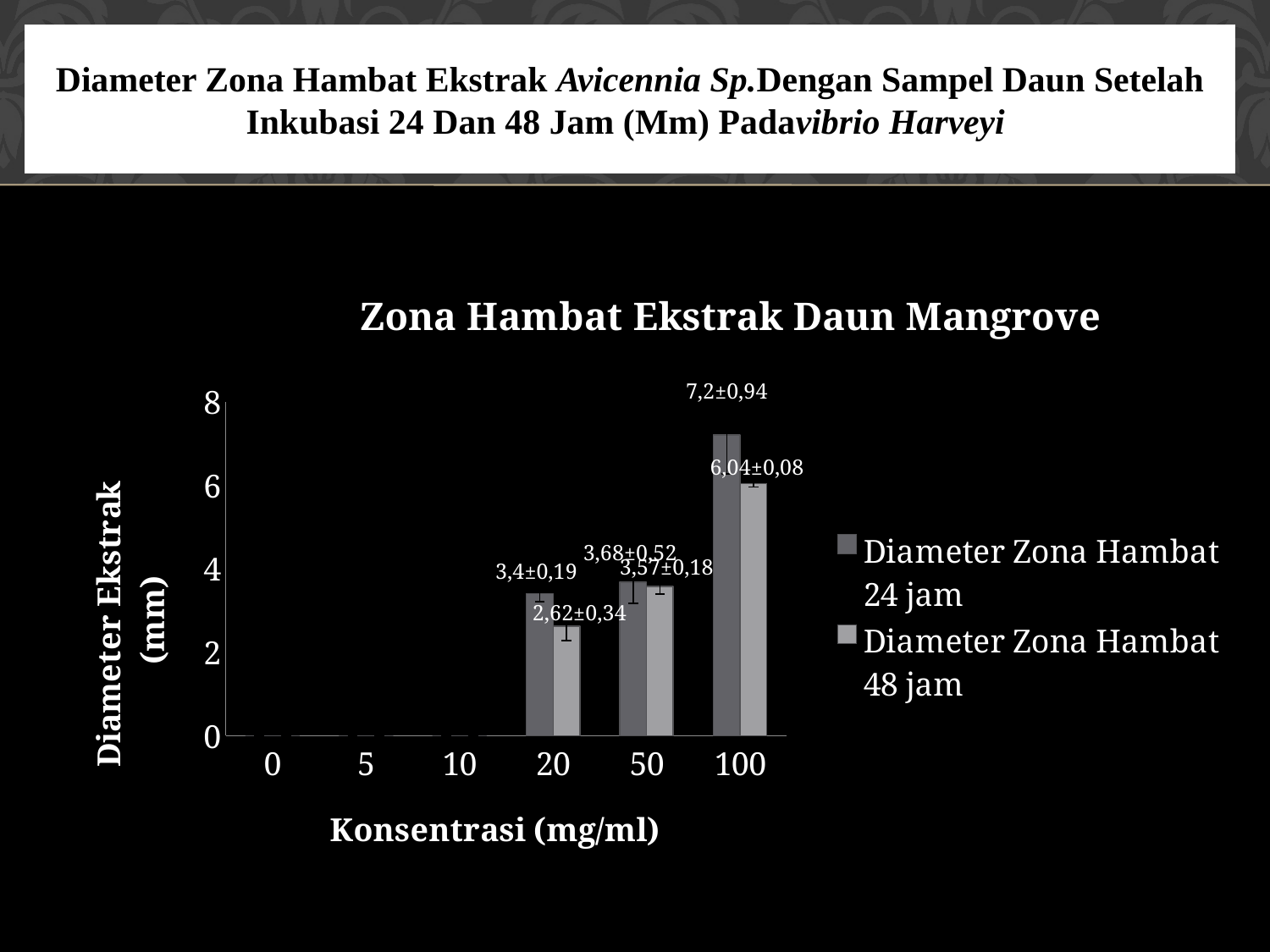
At concentration 20 mg/ml, which is larger: Diameter Zona Hambat 24 jam or Diameter Zona Hambat 48 jam? Diameter Zona Hambat 24 jam Among the concentrations 20, 50 and 100 mg/ml, which has the lowest Diameter Zona Hambat 48 jam value? 20 How many series does the legend list? 2 What is the data label for Diameter Zona Hambat 48 jam at concentration 50 mg/ml? 3,57±0,18 Which concentration has the highest Diameter Zona Hambat 24 jam value? 100 What kind of chart is shown on the slide? bar chart Is the Diameter Zona Hambat 24 jam value at concentration 100 mg/ml greater or less than 6? greater What is the title of the chart? Zona Hambat Ekstrak Daun Mangrove What is the data label for Diameter Zona Hambat 24 jam at concentration 20 mg/ml? 3,4±0,19 What is the data label for Diameter Zona Hambat 48 jam at concentration 20 mg/ml? 2,62±0,34 How many concentration categories are shown on the x axis? 6 What is the data label for Diameter Zona Hambat 24 jam at concentration 100 mg/ml? 7,2±0,94